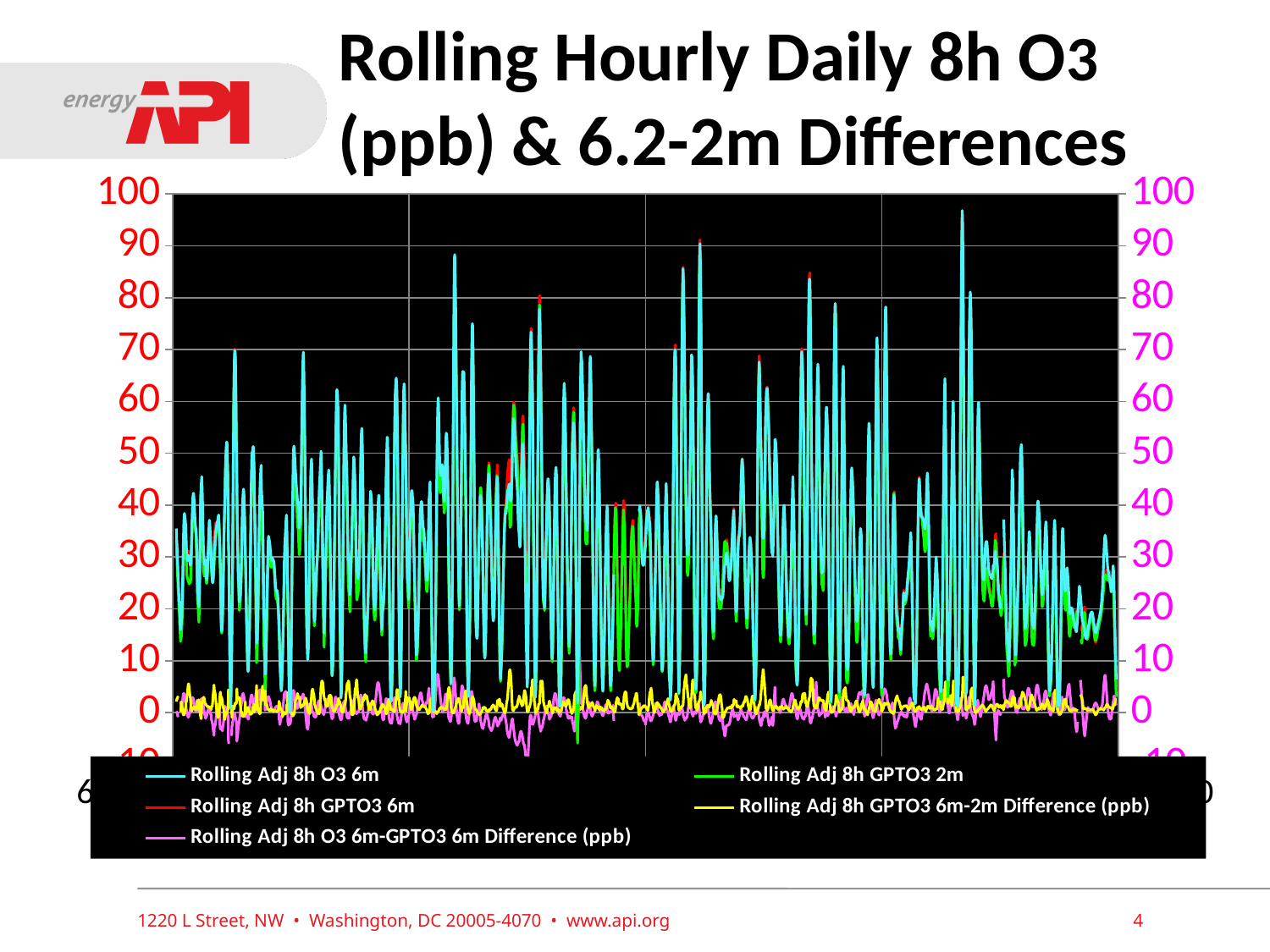
Are the values of the Rolling Adj 8h GPTO3 6m-2m Difference (ppb) series generally greater or less than 10? less Which series is drawn in yellow? Rolling Adj 8h GPTO3 6m-2m Difference (ppb) Is the highest peak of the Rolling Adj 8h O3 6m series greater or less than 90? greater Which series reaches higher values overall, Rolling Adj 8h O3 6m or Rolling Adj 8h GPTO3 6m-2m Difference (ppb)? Rolling Adj 8h O3 6m Does the Rolling Adj 8h O3 6m-GPTO3 6m Difference (ppb) series ever drop below 0? Yes How many series does the legend list? 5 What is the title of the chart? Rolling Hourly Daily 8h O3 (ppb) & 6.2-2m Differences What kind of chart is shown on the slide? Line chart